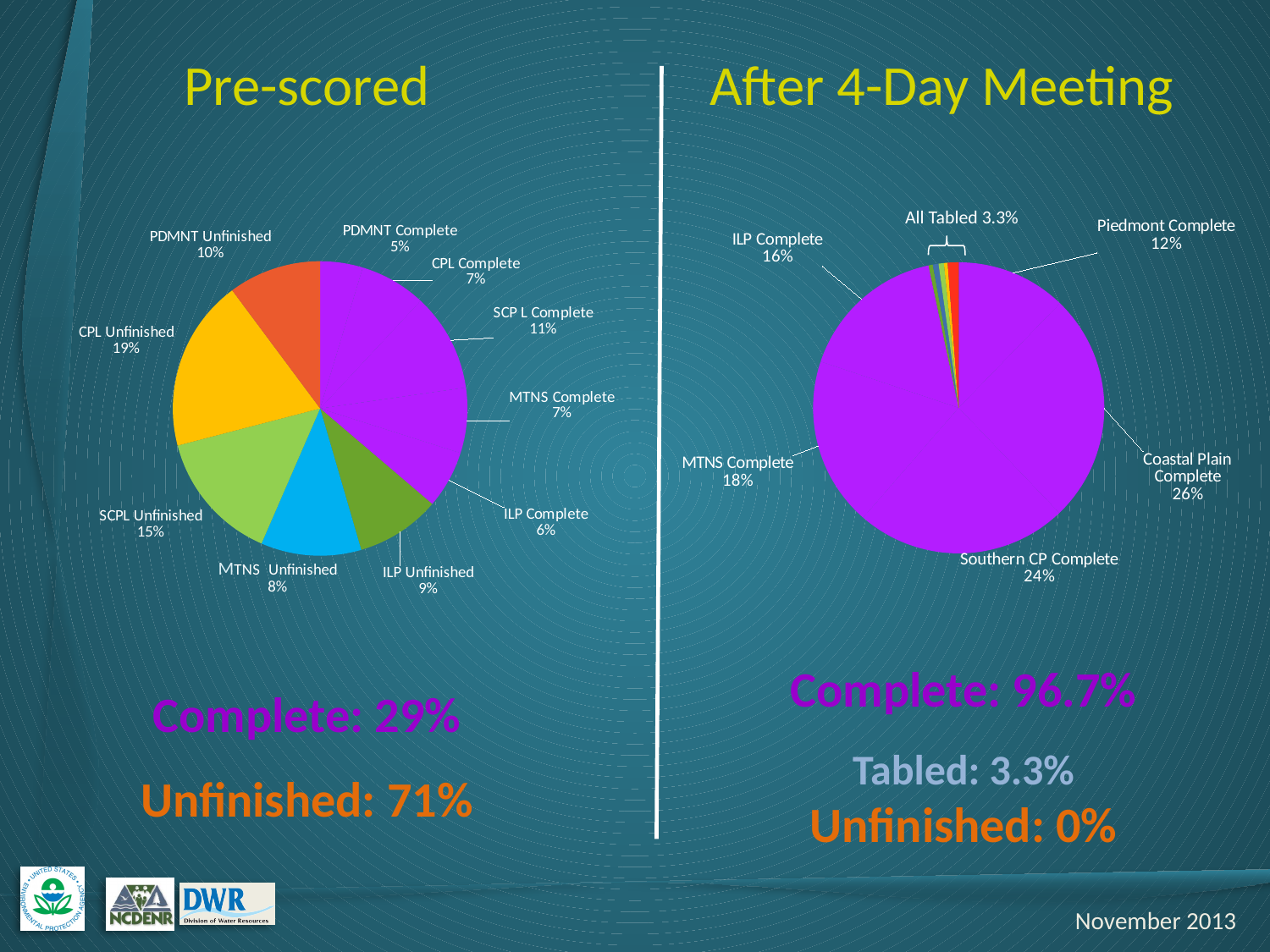
What is the title of the chart on the right side of the slide? After 4-Day Meeting In the Pre-scored chart, which slice has the largest share? CPL Unfinished In the Pre-scored chart, what is the difference between SCPL Unfinished and MTNS Unfinished? 7% What kind of chart is the Pre-scored chart? pie chart How many slices does the Pre-scored pie chart have? 10 In the Pre-scored chart, which slice has the smallest share? PDMNT Complete In the After 4-Day Meeting chart, what percentage is Coastal Plain Complete? 26% In the Pre-scored chart, what percentage is CPL Unfinished? 19% In the After 4-Day Meeting chart, what percentage is All Tabled? 3.3% In the After 4-Day Meeting chart, what is the difference between Southern CP Complete and Piedmont Complete? 12% In the Pre-scored chart, which is larger, ILP Unfinished or ILP Complete? ILP Unfinished In the Pre-scored chart, what percentage is SCP L Complete? 11%